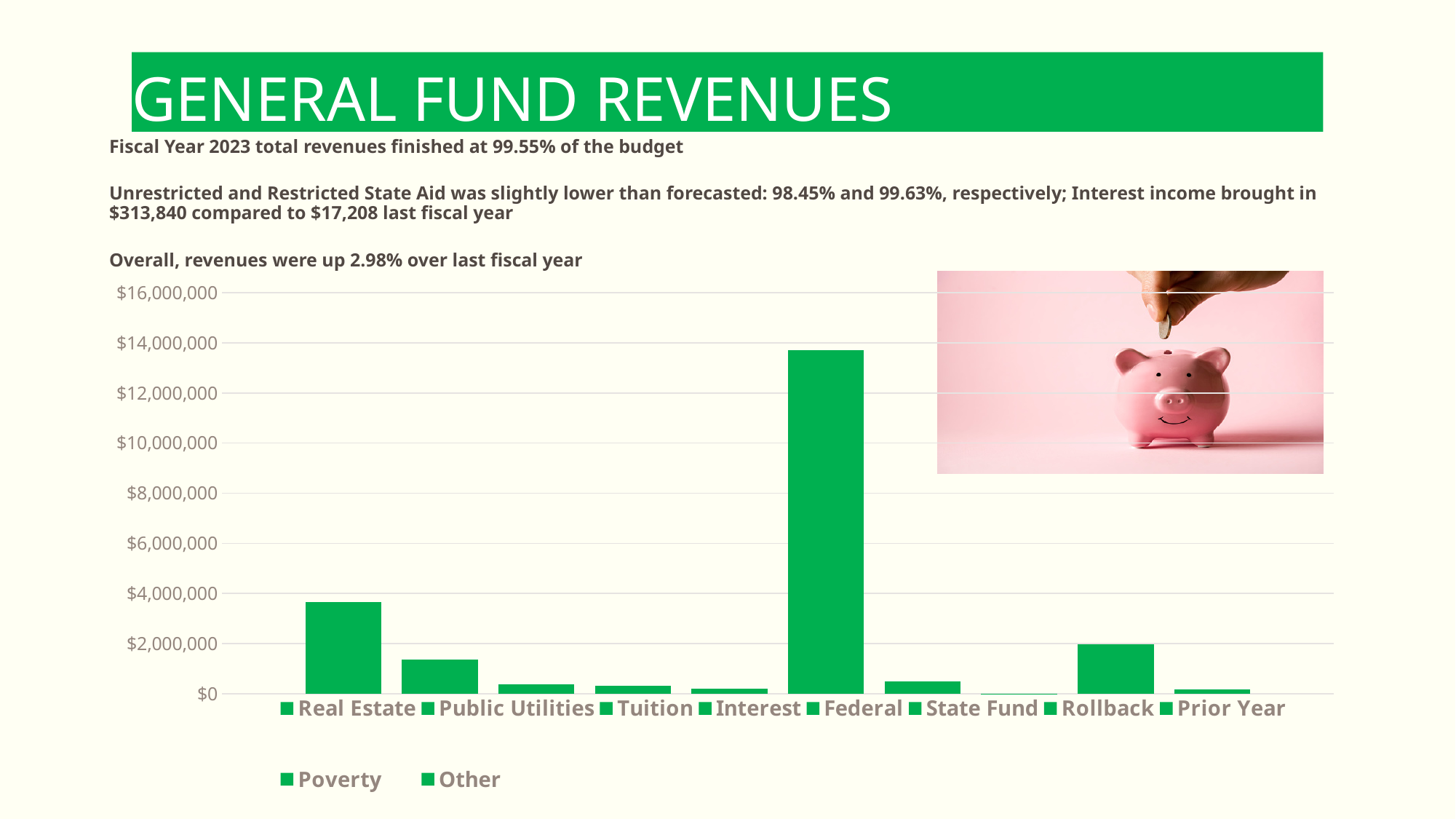
Which category has the highest revenue in the chart? State Fund Is the value for State Fund greater or less than $12,000,000? greater Which is larger, the value for Real Estate or the value for Public Utilities? Real Estate Is the value for Public Utilities greater or less than $2,000,000? less What kind of chart is shown on the slide? bar chart Which category has the lowest revenue in the chart? Prior Year What is the highest value shown on the chart's vertical axis? $16,000,000 How many entries does the chart legend list? 10 Which is larger, the value for Poverty or the value for Tuition? Poverty Is the value for Real Estate greater or less than $2,000,000? greater How many bars are plotted in the chart? 10